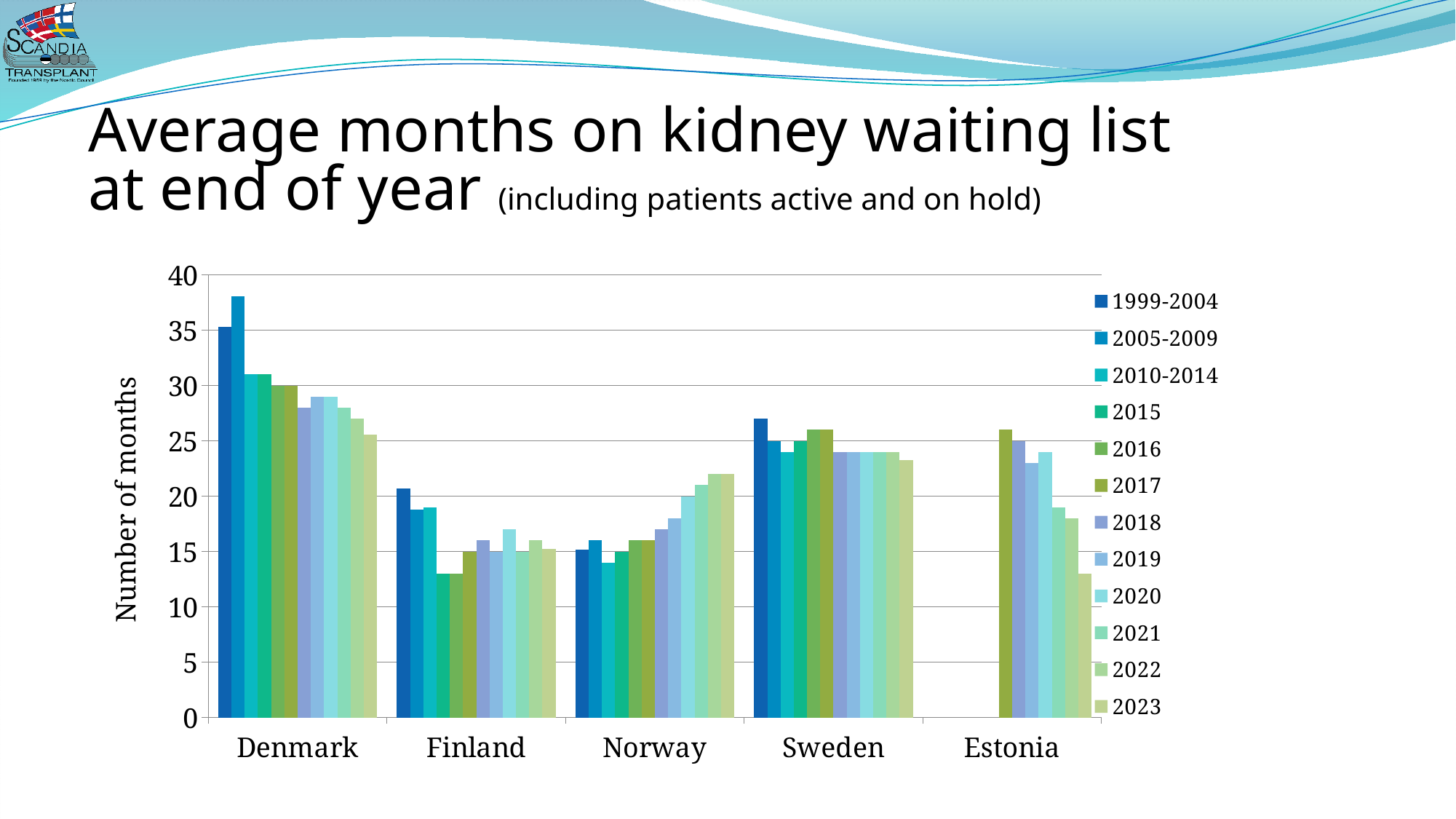
What is the label on the vertical axis of the chart? Number of months Which is larger in 2023, the value for Denmark or the value for Finland? Denmark Do the bars for Norway rise or fall from 2017 to 2023? rise Is the value for Estonia in 2023 greater or less than 15? less Is the value for Denmark in 2005-2009 greater or less than 35? greater What kind of chart is shown on the slide? bar chart Is the value for Finland in 2015 greater or less than 15? less How many series does the legend list? 12 Which country has the tallest bar in the chart? Denmark Which is larger in 2020, the value for Norway or the value for Finland? Norway How many countries are shown on the x axis of the chart? 5